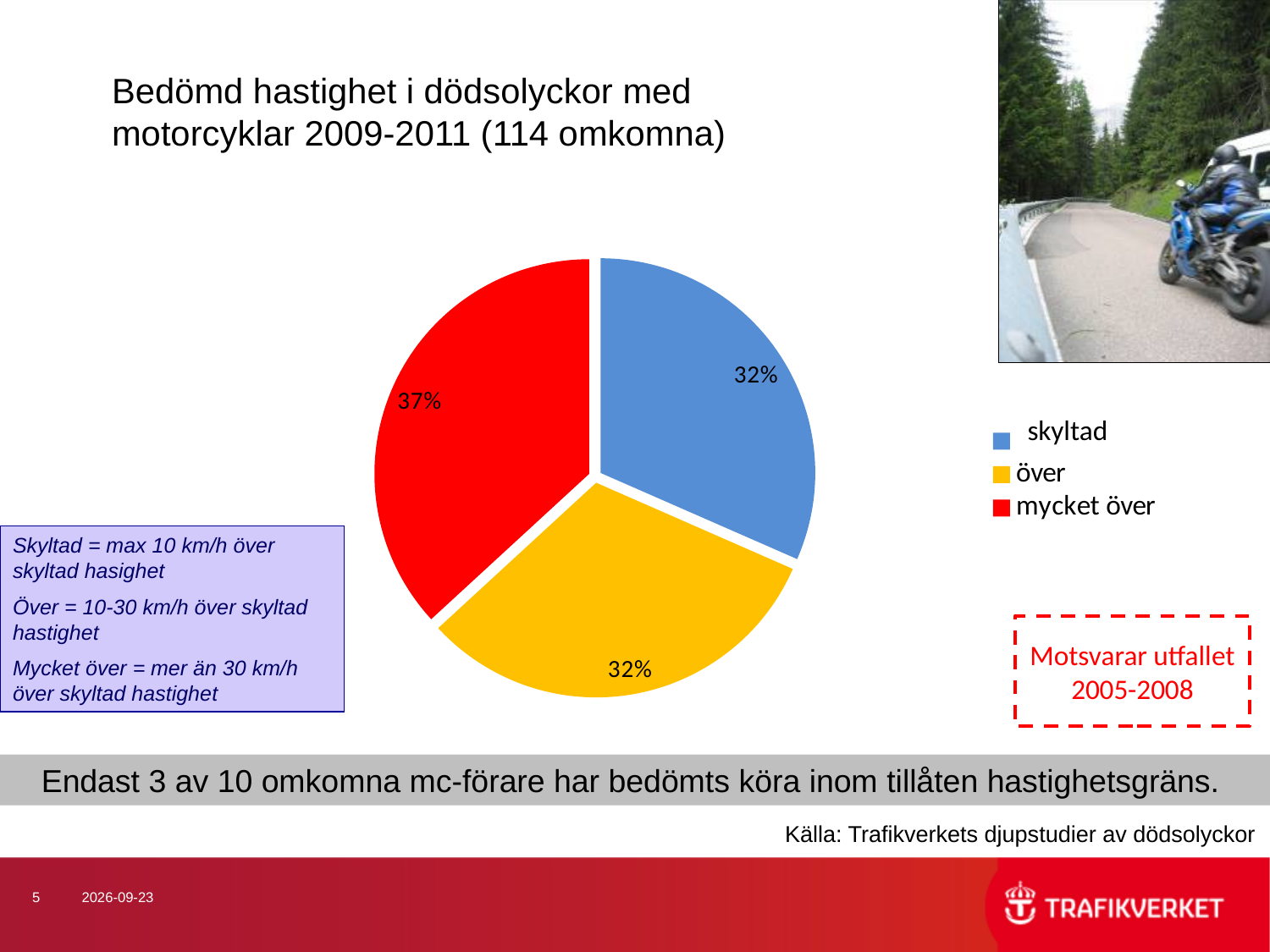
What kind of chart is shown on the slide? pie chart How many slices does the pie chart have? 3 Which colour represents 'skyltad' in the pie chart? blue What share of the pie is labelled for the 'mycket över' slice? 37% What share of the pie is labelled for the 'över' slice? 32% What is the title of the chart on the slide? Bedömd hastighet i dödsolyckor med motorcyklar 2009-2011 (114 omkomna) What share of the pie is labelled for the 'skyltad' slice? 32% Which slice is larger, 'mycket över' or 'över'? mycket över Which category has the largest slice of the pie? mycket över What is the difference in percentage points between the 'mycket över' slice and the 'skyltad' slice? 5 percentage points How many entries does the legend list? 3 What is the combined share of the 'över' and 'mycket över' slices? 69%